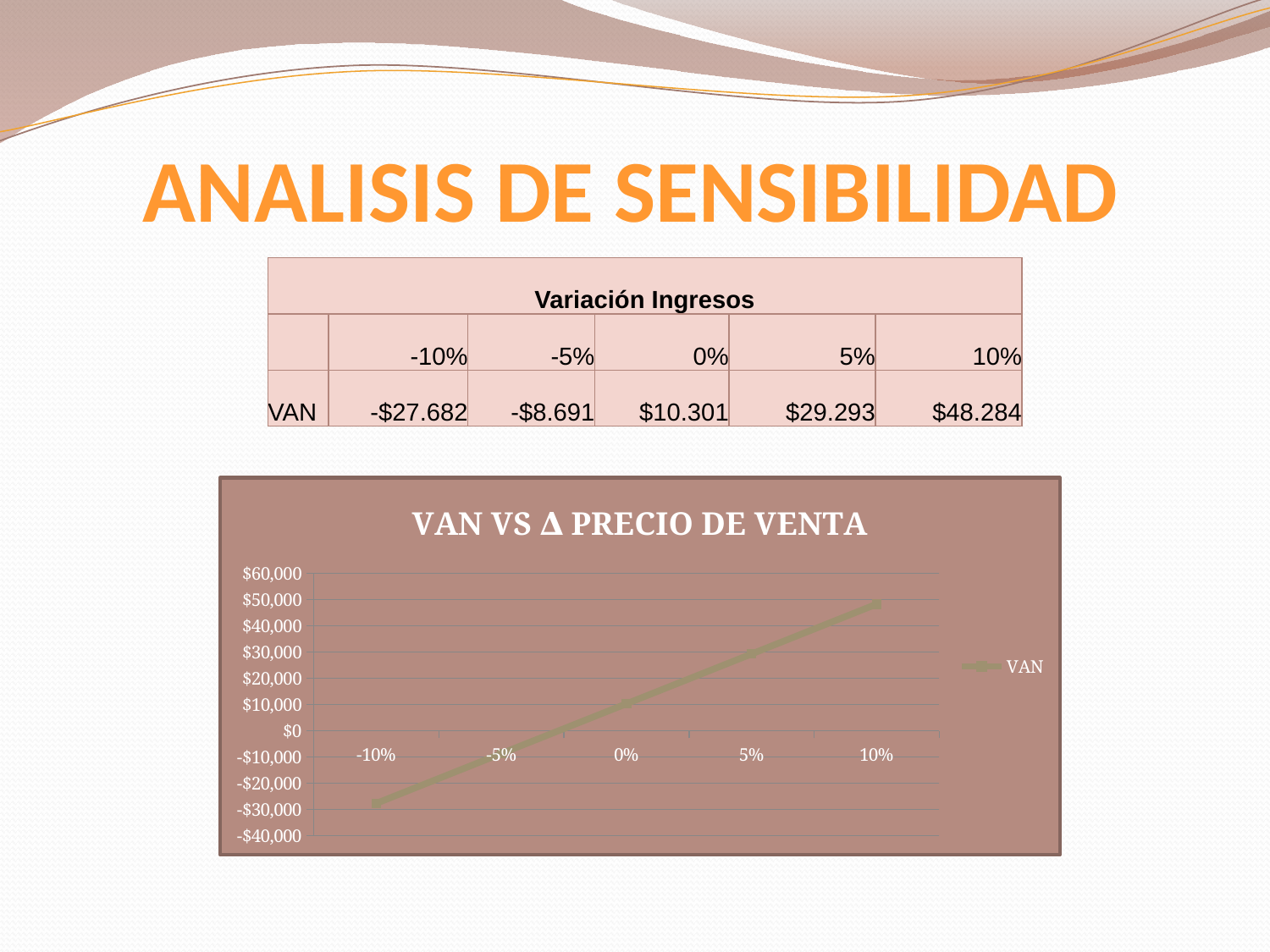
Does the VAN line rise or fall as the x axis goes from -10% to 10%? rise Is the VAN value at 10% greater or less than $40,000? greater At which x-axis category is VAN highest? 10% What is the title of the chart? VAN VS Δ PRECIO DE VENTA Is the VAN value at 5% greater or less than $20,000? greater What type of chart is shown on the slide? line chart According to the table on the slide, what is the VAN at a 10% variation in income? $48.284 How many data points are plotted on the VAN line? 5 At which x-axis category is VAN lowest? -10% Which is larger, the VAN at 0% or the VAN at -5%? 0% Is the VAN value at -10% greater or less than -$20,000? less How many series does the chart legend list? 1